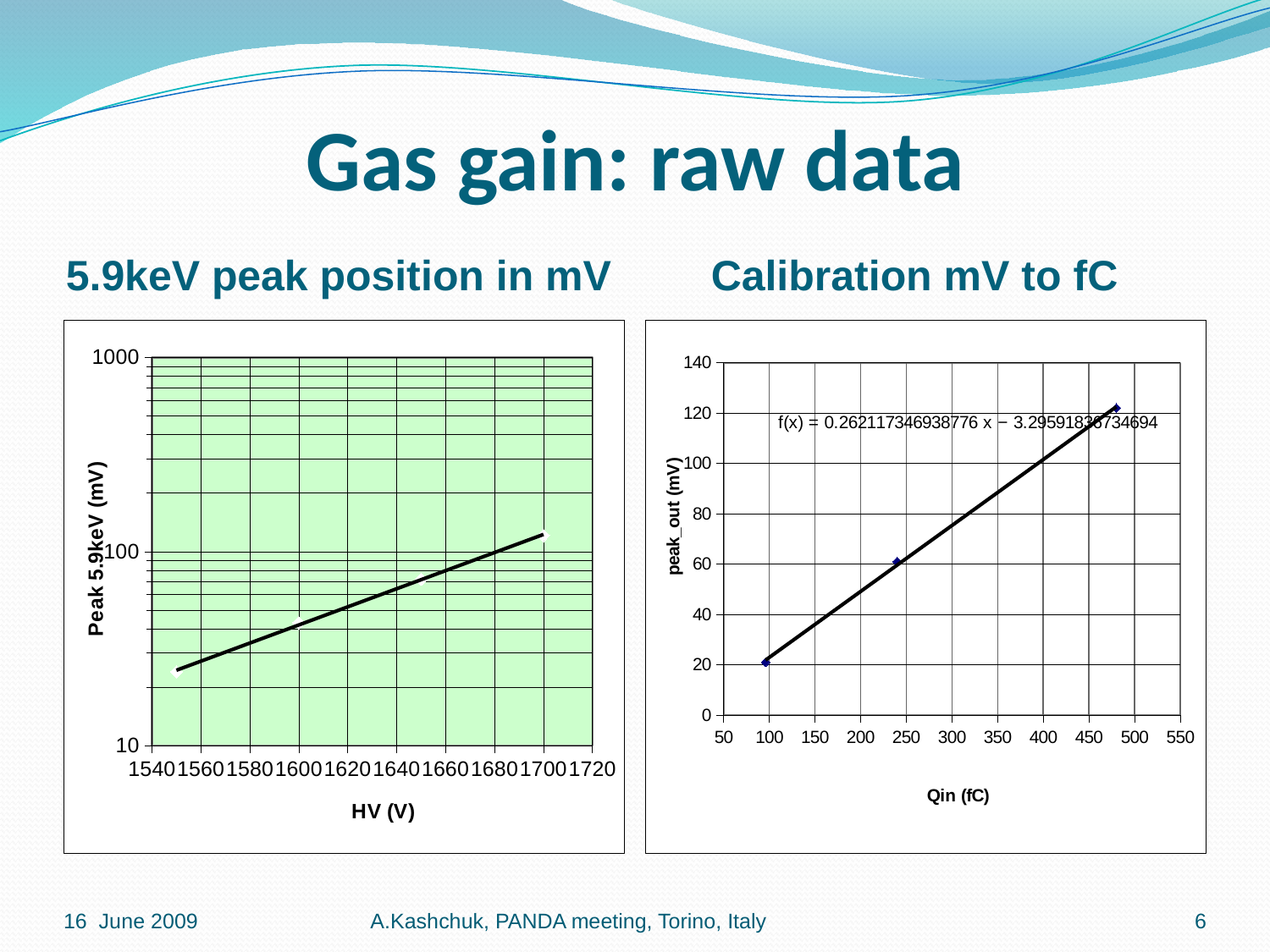
In the left chart '5.9keV peak position in mV', does the peak position rise or fall as HV increases? rise In the right chart 'Calibration mV to fC', what is the x-axis title? Qin (fC) In the right chart 'Calibration mV to fC', does peak_out rise or fall as Qin increases? rise What kind of chart is the left chart, '5.9keV peak position in mV'? line chart In the right chart 'Calibration mV to fC', how many data points are plotted? 3 In the left chart '5.9keV peak position in mV', what is the x-axis title? HV (V) In the left chart '5.9keV peak position in mV', is the value for the point at the highest HV greater or less than 100? greater In the right chart 'Calibration mV to fC', is the value for the point at the highest Qin greater or less than 100? greater What kind of chart is the right chart, 'Calibration mV to fC'? scatter chart with a fitted line In the right chart 'Calibration mV to fC', is the value for the point at the lowest Qin greater or less than 40? less In the left chart '5.9keV peak position in mV', how many data points are plotted? 4